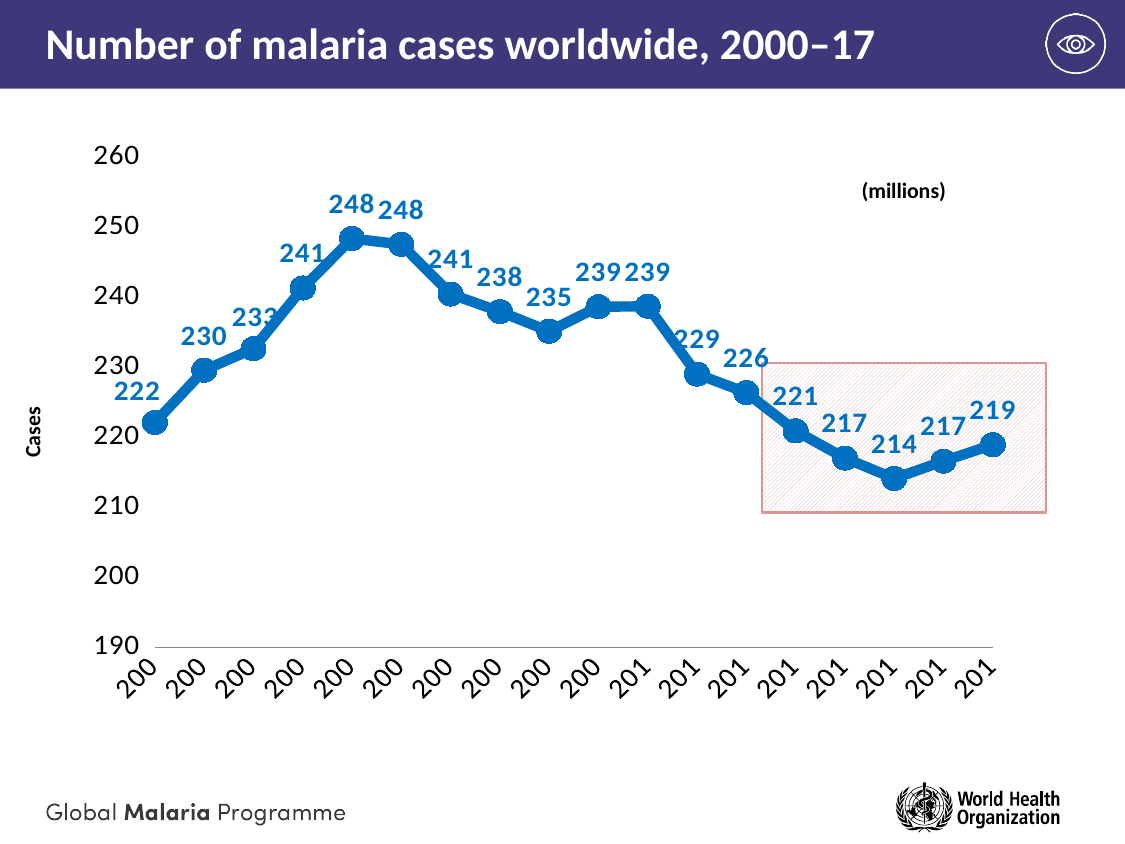
What is the lowest value plotted on the chart? 214 How many data points are plotted on the line? 18 What is the title of the chart? Number of malaria cases worldwide, 2000–17 What is the highest value plotted on the chart? 248 Is the lowest value on the chart greater or less than 220? less What is the difference between the highest value (248) and the lowest value (214) on the chart? 34 What is the value of the last data point on the line (year 2017)? 219 Do the values rise or fall from the first data point to the peak of the line? rise Which is larger, the first data point on the line or the last data point? the first data point (222) What is the difference between the first data point (222) and the last data point (219)? 3 What kind of chart is shown on the slide? line chart What is the value of the first data point on the line (year 2000)? 222